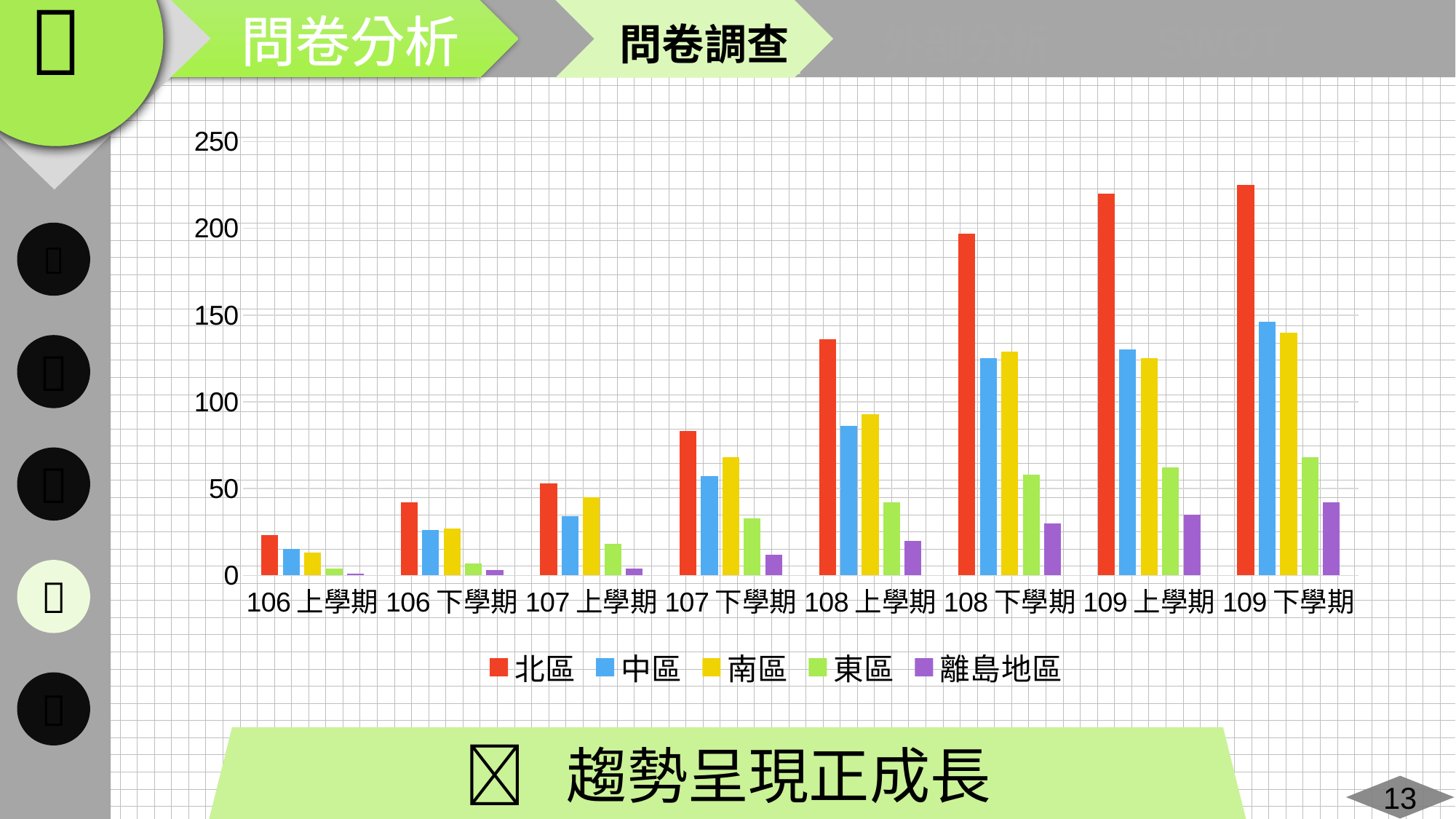
Is the value for 北區 in 108 上學期 greater or less than 150? less Is the value for 北區 in 106 上學期 greater or less than 50? less Which is larger in 108 上學期: the value for 南區 or the value for 東區? 南區 How many semester categories are shown on the x axis of the chart? 8 Is the value for 北區 in 109 下學期 greater or less than 200? greater How many series does the chart's legend list? 5 What kind of chart is shown on the slide? bar chart What colour represents 離島地區 in the chart's legend? purple Do the values for 北區 rise or fall from 106 上學期 to 109 下學期? rise Which series has the lowest bar in the 106 上學期 category? 離島地區 Which series has the highest bar in the 109 下學期 category? 北區